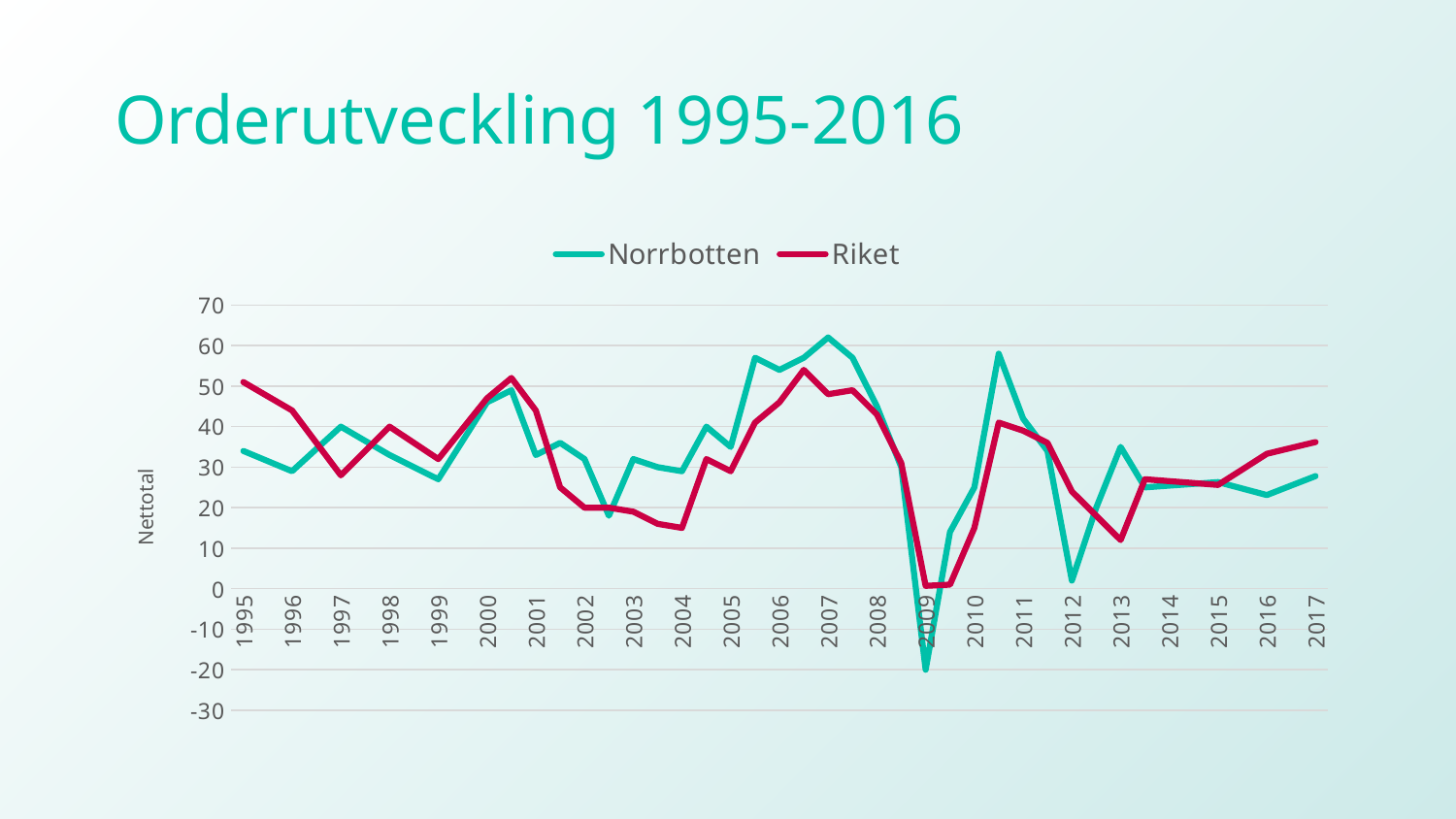
What is the title of the chart? Orderutveckling 1995-2016 Is the value for Norrbotten in 2009 greater or less than 0? less What kind of chart is shown on the slide? Line chart What is the label on the vertical axis? Nettotal In which year does the Norrbotten line reach its lowest value? 2009 In 2010, which series has the higher value, Norrbotten or Riket? Norrbotten In 1995, which series has the higher value, Norrbotten or Riket? Riket How many series does the legend list? 2 In which year does the Norrbotten line reach its highest value? 2007 Is the value for Riket in 1995 greater or less than 40? greater Is the value for Riket in 2004 greater or less than 20? less